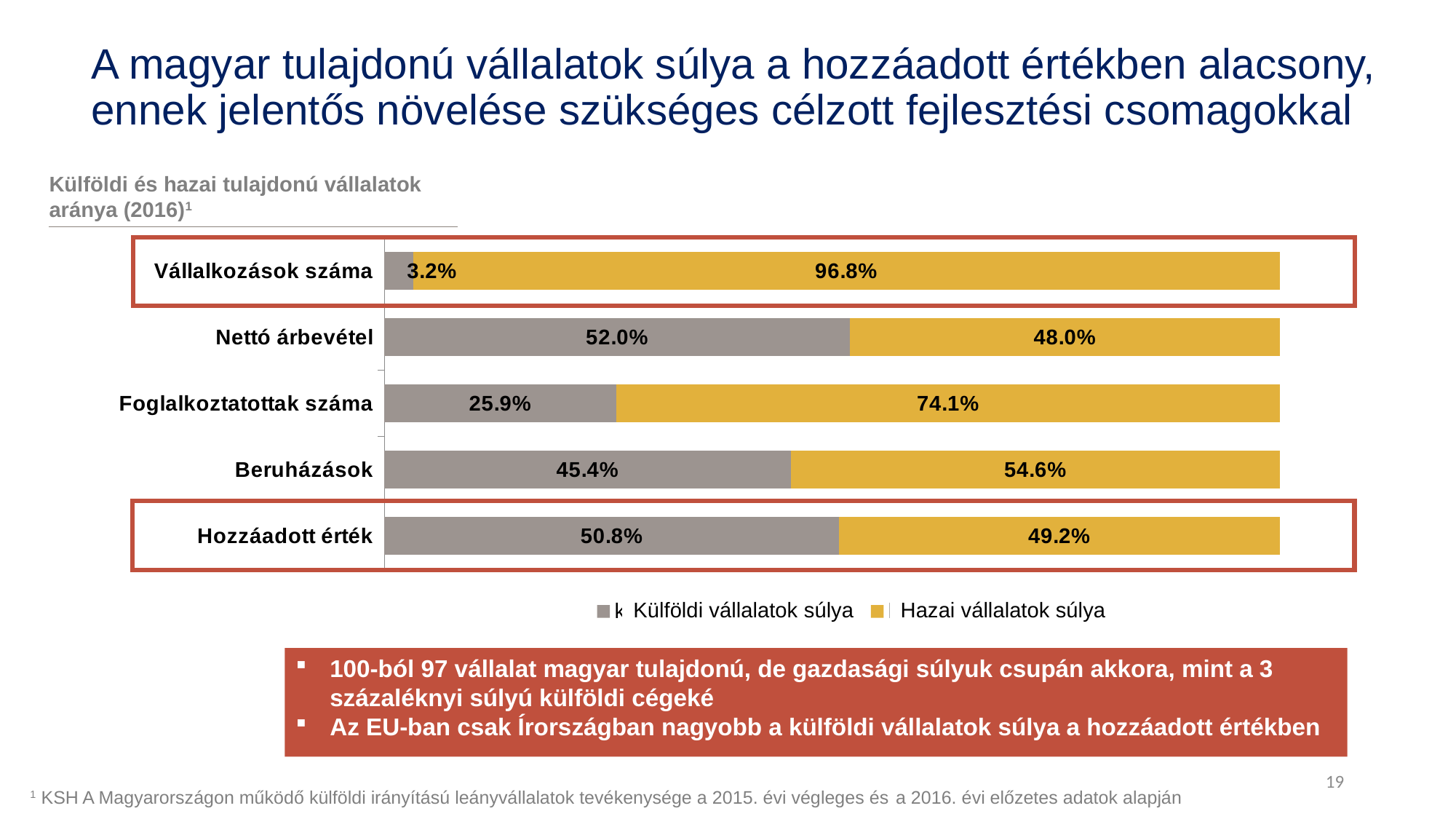
What is the total of the stacked bar for Beruházások? 100% For Nettó árbevétel, which is larger: Külföldi vállalatok súlya or Hazai vállalatok súlya? Külföldi vállalatok súlya What is the difference between Hazai vállalatok súlya and Külföldi vállalatok súlya for Foglalkoztatottak száma? 48.2 percentage points Which category has the lowest value for Külföldi vállalatok súlya? Vállalkozások száma What is the value of Hazai vállalatok súlya for Vállalkozások száma? 96.8% What is the value of Hazai vállalatok súlya for Beruházások? 54.6% Which category has the highest value for Külföldi vállalatok súlya? Nettó árbevétel What is the value of Külföldi vállalatok súlya for Hozzáadott érték? 50.8% What is the value of Külföldi vállalatok súlya for Foglalkoztatottak száma? 25.9% How many categories are shown in the chart? 5 What kind of chart is shown on the slide? Stacked bar chart How many series does the legend list? 2